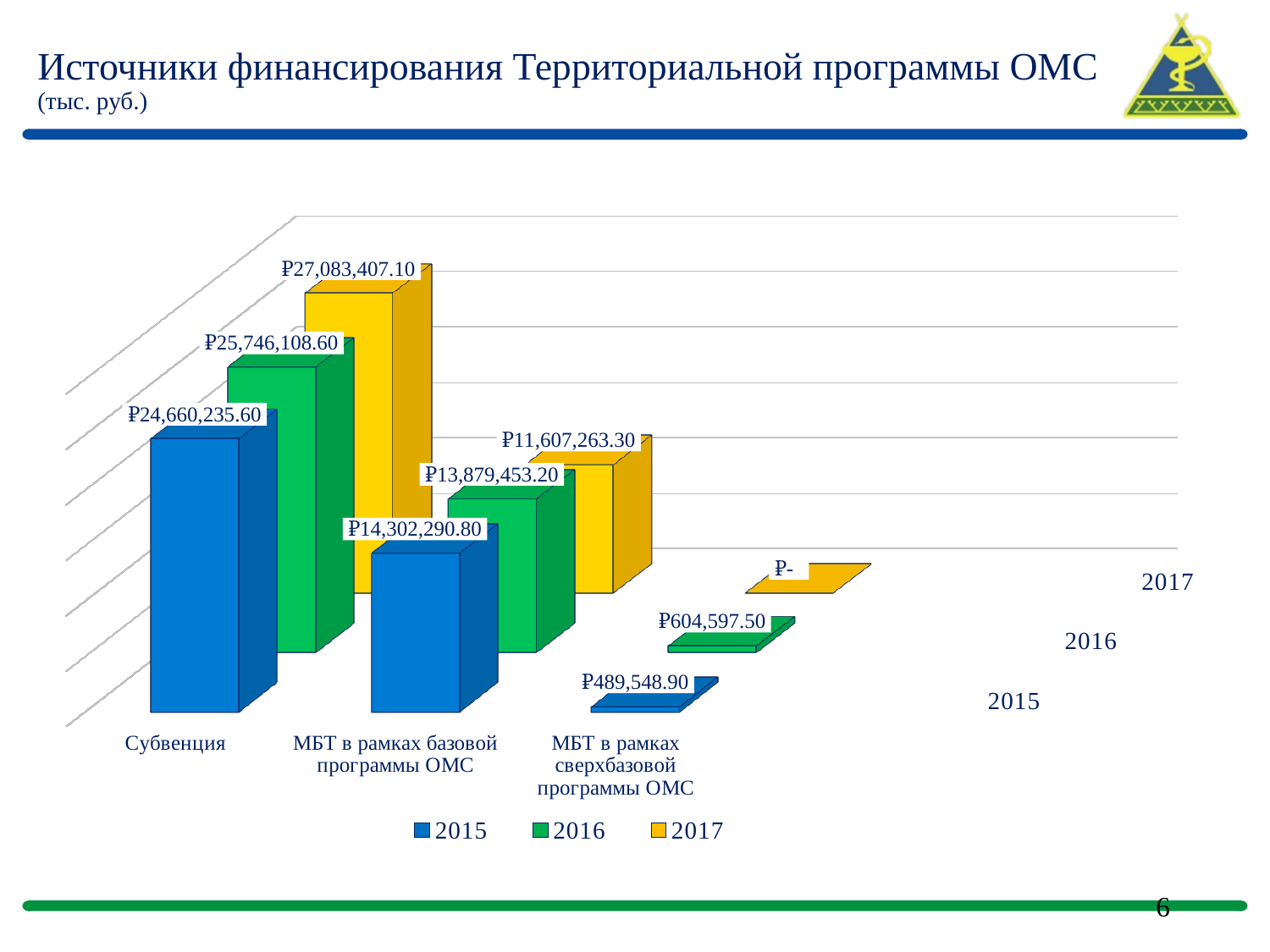
Which year has the lowest value for МБТ в рамках базовой программы ОМС? 2017 What is the difference between the 2017 and 2015 values for Субвенция? ₽2,423,171.50 What is the value for Субвенция in 2016? ₽25,746,108.60 What is the difference between the 2016 and 2015 values for МБТ в рамках сверхбазовой программы ОМС? ₽115,048.60 What is the value for МБТ в рамках сверхбазовой программы ОМС in 2016? ₽604,597.50 Which is larger: the 2015 value for Субвенция or the 2015 value for МБТ в рамках базовой программы ОМС? Субвенция How many categories are shown on the x axis? 3 What kind of chart is shown on the slide? Bar chart What is the value for МБТ в рамках базовой программы ОМС in 2015? ₽14,302,290.80 How many series does the legend list? 3 Which year has the highest value for Субвенция? 2017 What is the value for Субвенция in 2017? ₽27,083,407.10